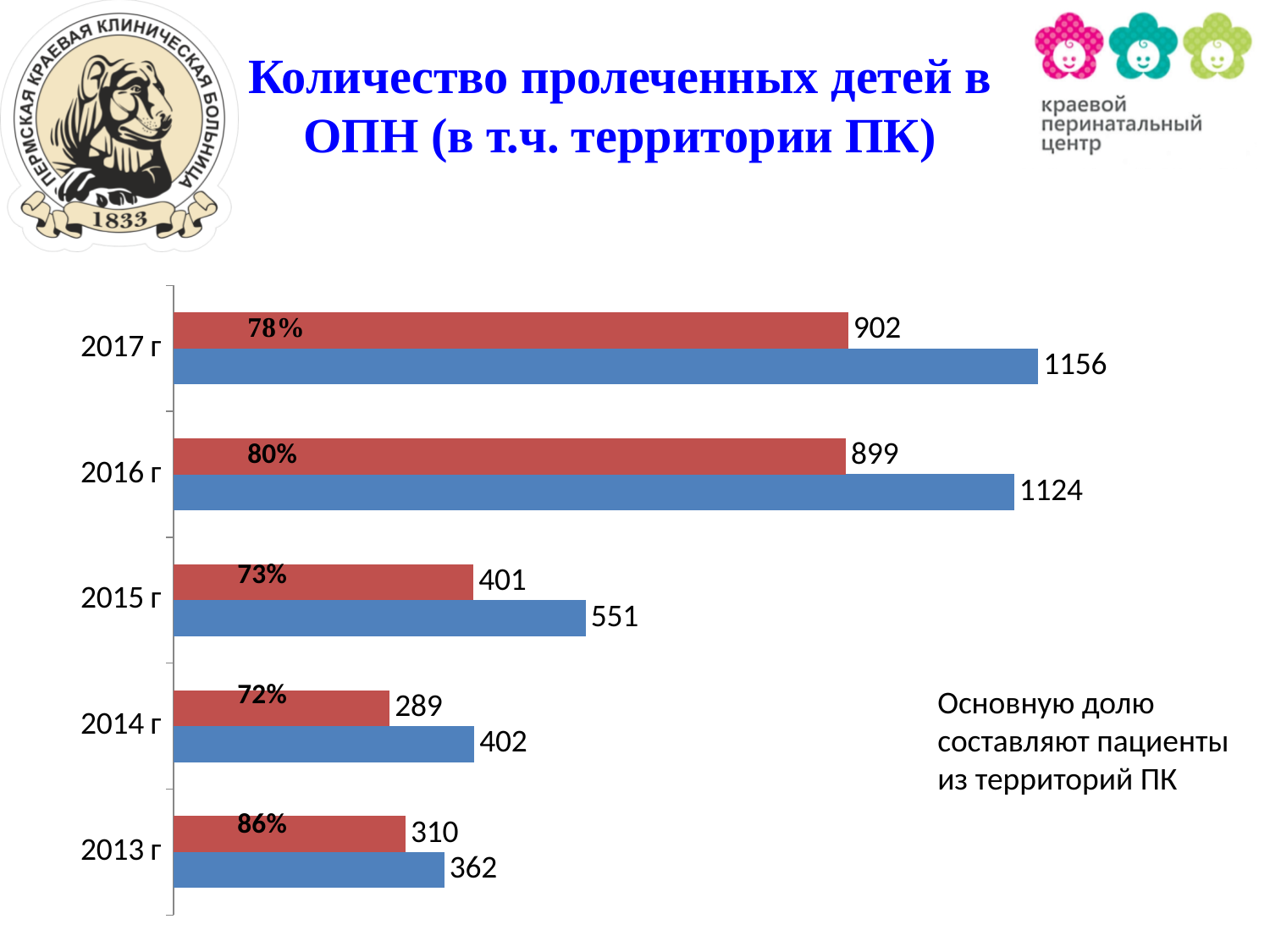
What type of chart is shown on the slide? bar chart What is the difference between the blue bar values for 2015 г and 2014 г? 149 Which year has the highest blue bar value? 2017 г What is the value of the blue bar for 2017 г? 1156 What is the value of the red bar for 2015 г? 401 Do the blue bar values rise or fall from 2013 г to 2017 г? rise Which is larger: the red bar for 2013 г or the red bar for 2014 г? 2013 г What is the difference between the blue bar and the red bar for 2016 г? 225 Which year has the lowest red bar value? 2014 г What percentage is printed on the red bar for 2013 г? 86% What is the title of the chart on the slide? Количество пролеченных детей в ОПН (в т.ч. территории ПК) How many years are shown on the chart? 5